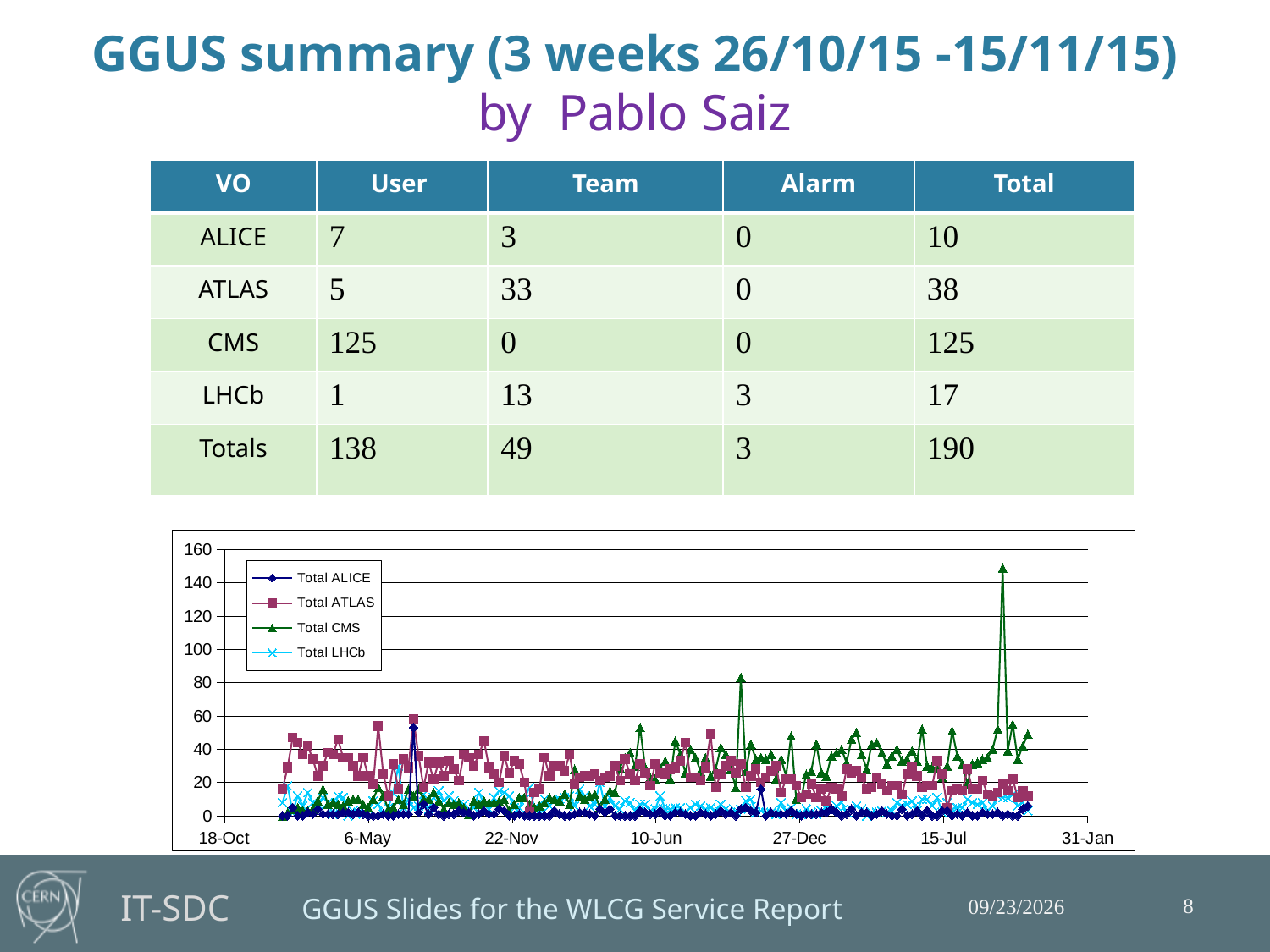
Is the highest value of the Total ATLAS series greater or less than 80? less Which series is drawn in green with triangle markers? Total CMS Which series reaches the highest peak value in the chart? Total CMS Is the highest peak of the Total CMS series greater or less than 140? greater Which series stays lowest, closest to zero, across the chart? Total ALICE What is the highest value shown on the chart's y axis? 160 Is the highest value of the Total ALICE series greater or less than 80? less What kind of chart is shown at the bottom of the slide? line chart How many series does the chart legend list? 4 Which series has a higher peak, Total CMS or Total ATLAS? Total CMS How many date labels are shown on the x axis of the chart? 7